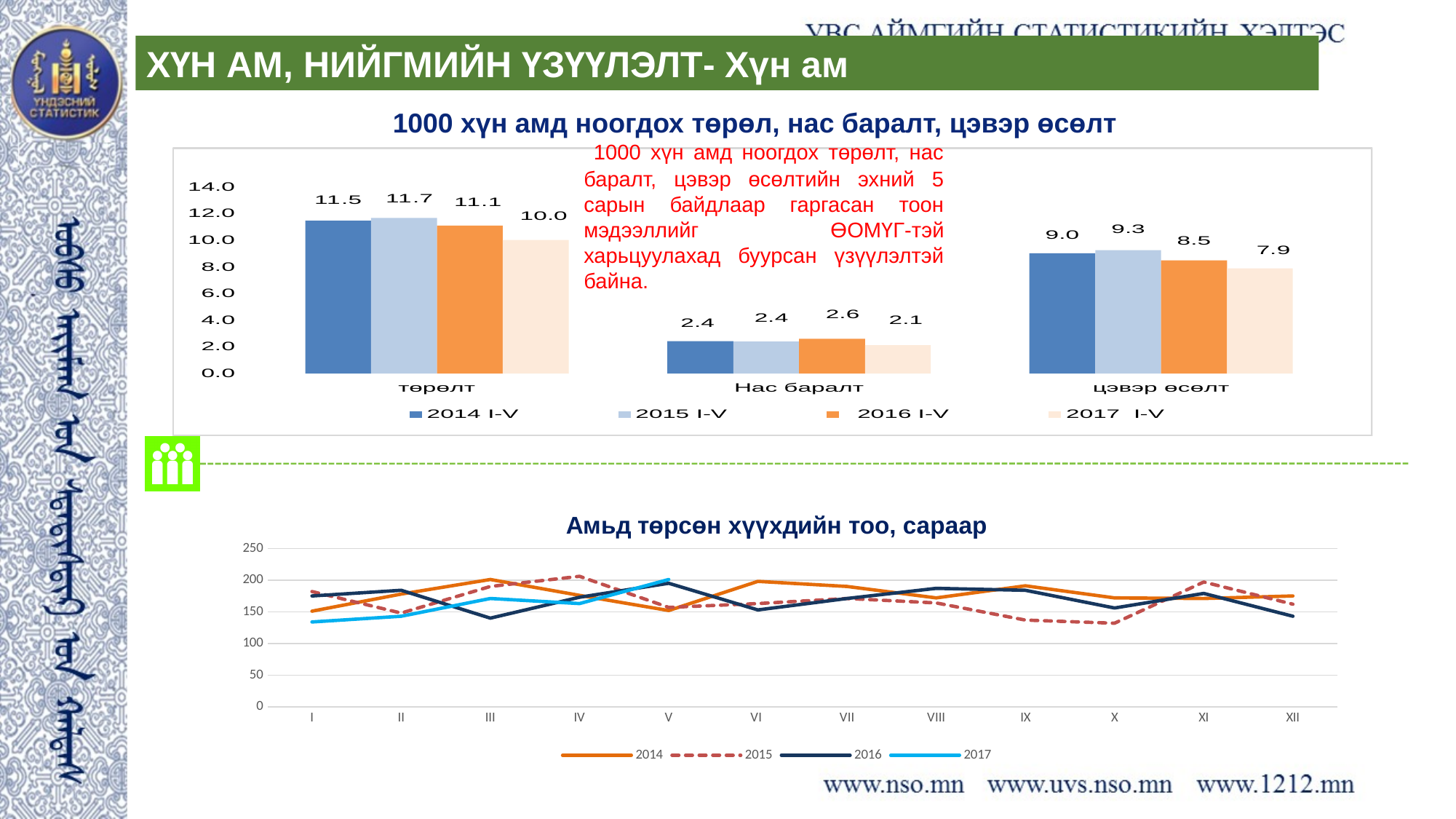
In the chart titled '1000 хүн амд ноогдох төрөл, нас баралт, цэвэр өсөлт', what is the value for төрөлт in 2014 I-V? 11.5 What kind of chart is the chart titled 'Амьд төрсөн хүүхдийн тоо, сараар'? line chart In the chart titled '1000 хүн амд ноогдох төрөл, нас баралт, цэвэр өсөлт', what is the value for Нас баралт in 2016 I-V? 2.6 In the chart titled '1000 хүн амд ноогдох төрөл, нас баралт, цэвэр өсөлт', which is larger: цэвэр өсөлт in 2014 I-V or in 2016 I-V? 2014 I-V In the chart titled 'Амьд төрсөн хүүхдийн тоо, сараар', is the value for 2017 in month I greater or less than 150? less In the chart titled '1000 хүн амд ноогдох төрөл, нас баралт, цэвэр өсөлт', which year has the highest value for төрөлт? 2015 I-V How many series does the legend of the chart titled '1000 хүн амд ноогдох төрөл, нас баралт, цэвэр өсөлт' list? 4 In the chart titled '1000 хүн амд ноогдох төрөл, нас баралт, цэвэр өсөлт', what is the value for цэвэр өсөлт in 2017 I-V? 7.9 In the chart titled '1000 хүн амд ноогдох төрөл, нас баралт, цэвэр өсөлт', what is the difference between the төрөлт values for 2015 I-V and 2017 I-V? 1.7 In the chart titled '1000 хүн амд ноогдох төрөл, нас баралт, цэвэр өсөлт', which year has the lowest value for цэвэр өсөлт? 2017 I-V How many months are shown on the x axis of the chart titled 'Амьд төрсөн хүүхдийн тоо, сараар'? 12 In the chart titled 'Амьд төрсөн хүүхдийн тоо, сараар', is the value for 2015 in month X greater or less than 150? less